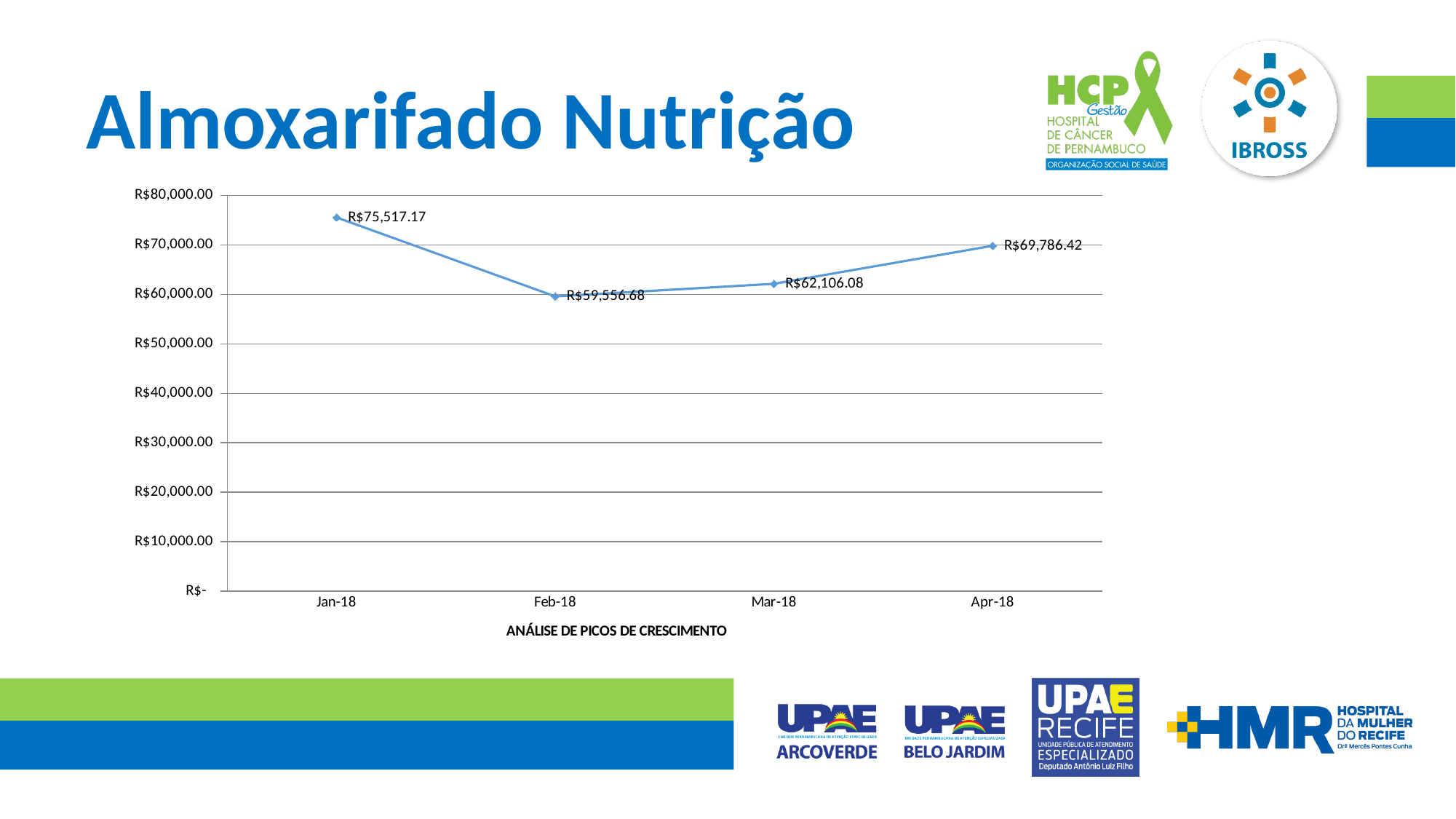
Which month has the highest value? Jan-18 What kind of chart is shown on the slide? line chart Is the value for Feb-18 greater or less than R$60,000.00? less What is the value for Mar-18? R$62,106.08 What is the value for Apr-18? R$69,786.42 How many months are plotted on the chart? 4 What is the difference between the values for Apr-18 and Mar-18? R$7,680.34 Which month has the lowest value? Feb-18 What is the value for Jan-18? R$75,517.17 What is the difference between the values for Jan-18 and Feb-18? R$15,960.49 Which is larger, the value for Mar-18 or the value for Apr-18? Apr-18 What is the value for Feb-18? R$59,556.68